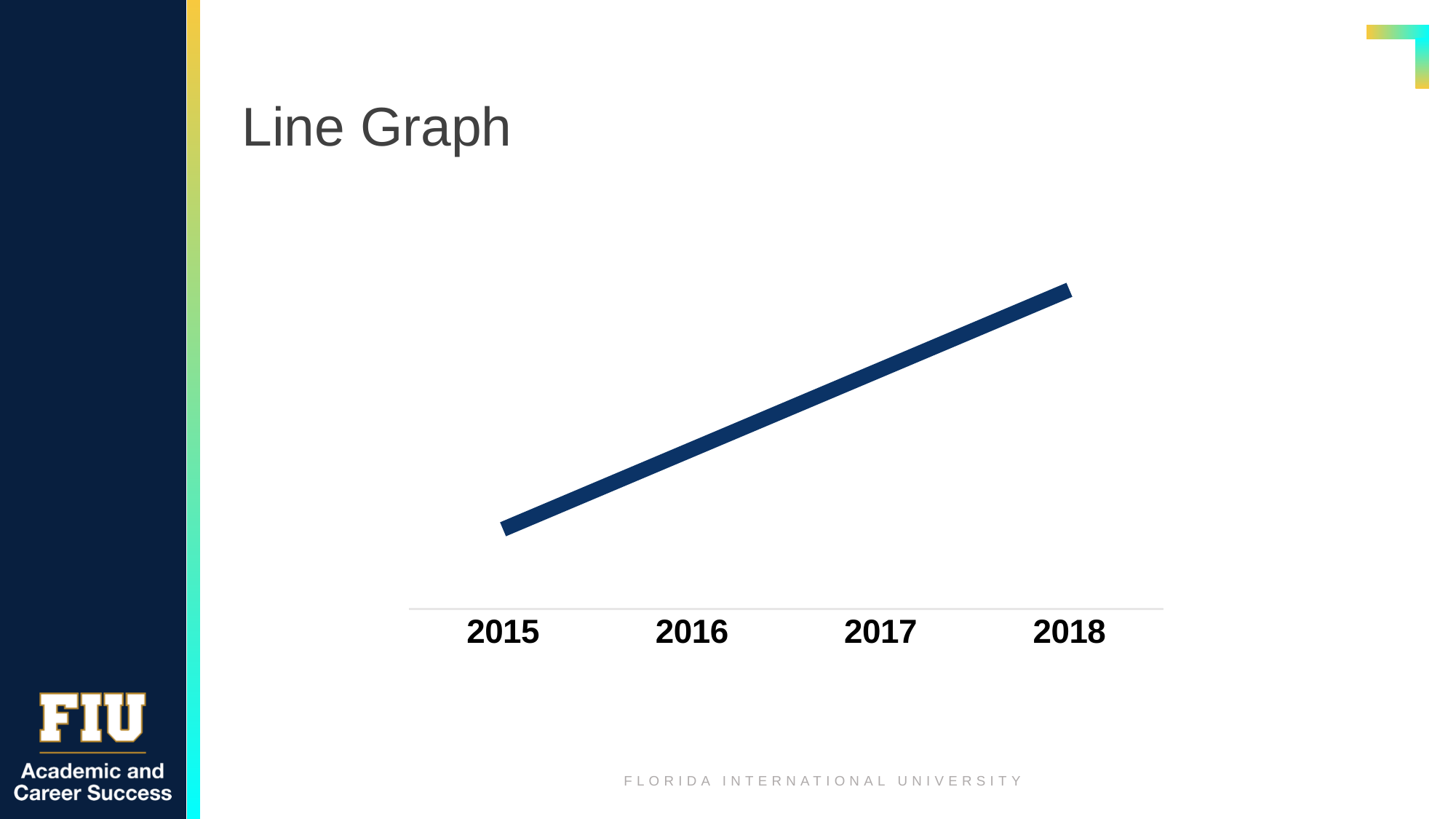
Which year has the lowest value on the line? 2015 What is the title of the slide containing the chart? Line Graph Do the values rise or fall from 2015 to 2018? rise Which is larger, the value for 2015 or the value for 2018? 2018 Which is larger, the value for 2016 or the value for 2017? 2017 What kind of chart is shown on the slide? line chart How many years are labelled on the x axis? 4 What is the first year shown on the x axis? 2015 Which year has the highest value on the line? 2018